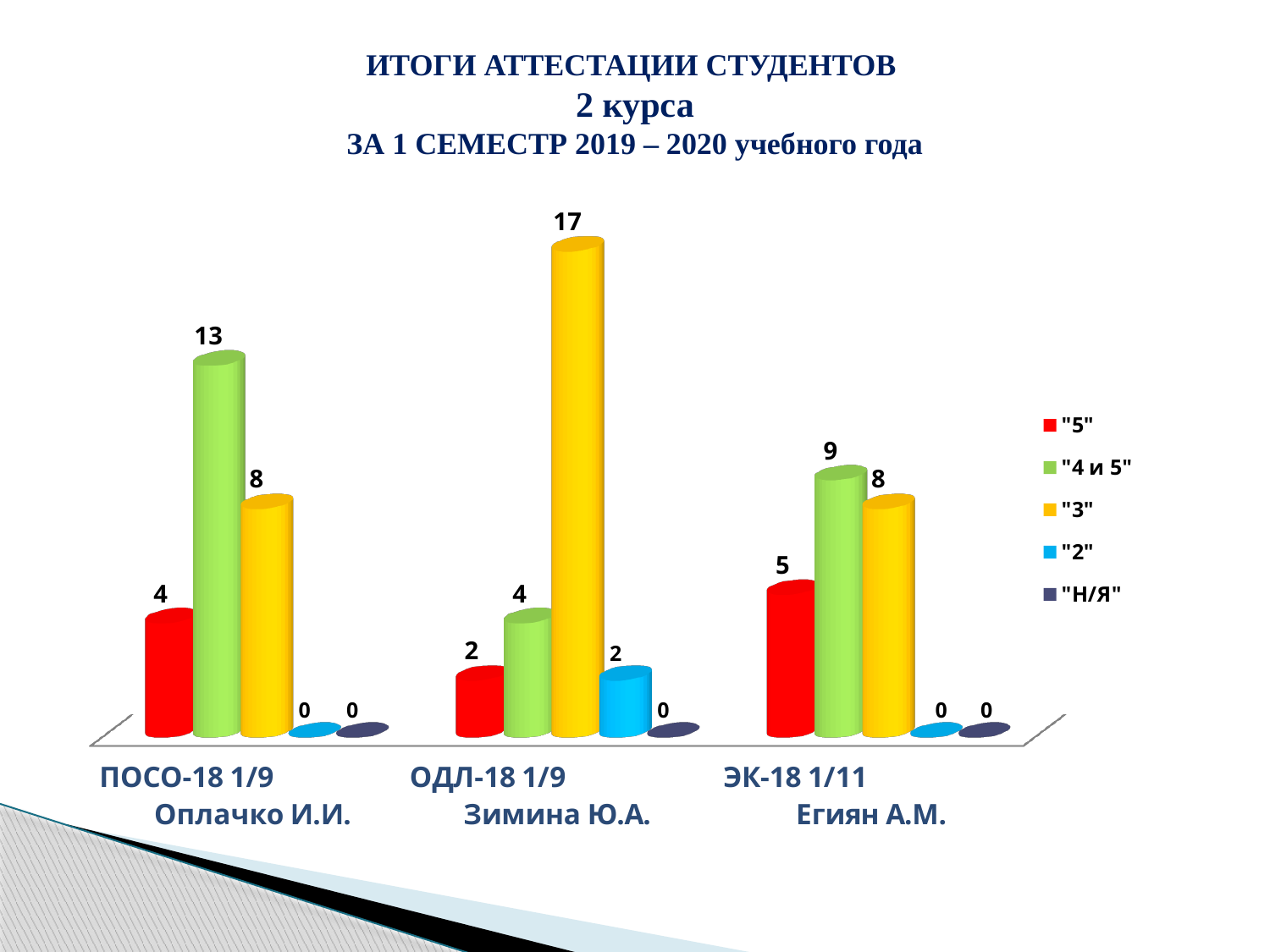
What kind of chart is shown on the slide? bar chart How many groups (categories) are shown on the x axis? 3 Which is larger: the "4 и 5" value for ОДЛ-18 1/9 or the "4 и 5" value for ЭК-18 1/11? ЭК-18 1/11 Which group has the highest value for "3"? ОДЛ-18 1/9 What is the total of all five series for ОДЛ-18 1/9? 25 What is the value of "4 и 5" for ПОСО-18 1/9? 13 How many series does the legend list? 5 What is the value of "5" for ЭК-18 1/11? 5 What is the value of "3" for ОДЛ-18 1/9? 17 Which group has the lowest value for "5"? ОДЛ-18 1/9 What is the value of "2" for ОДЛ-18 1/9? 2 What is the difference between the "4 и 5" values for ПОСО-18 1/9 and ЭК-18 1/11? 4